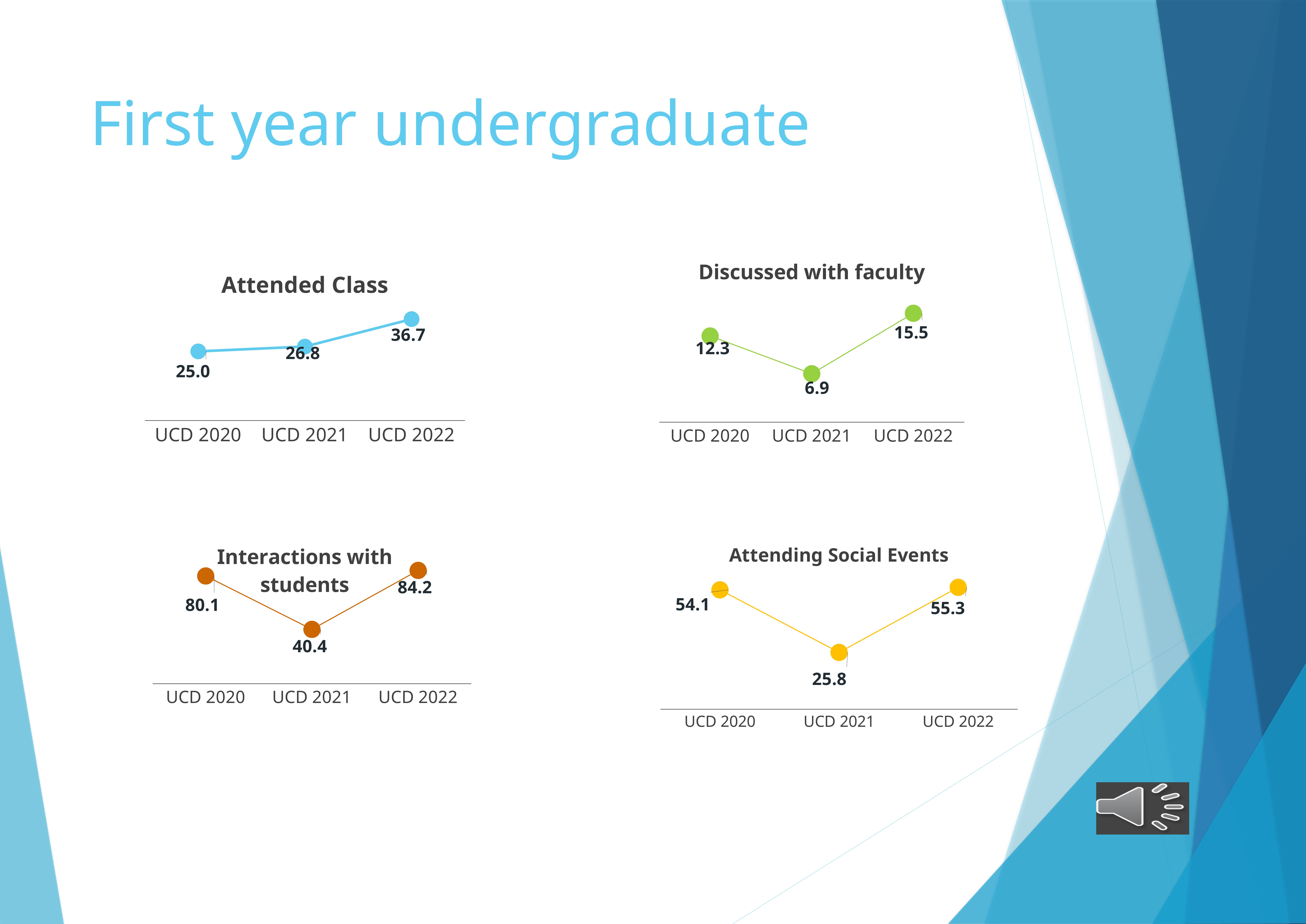
How many charts are shown on the slide? 4 In the 'Attended Class' chart, do the values rise or fall from UCD 2020 to UCD 2022? Rise In the 'Attended Class' chart, what is the difference between the UCD 2022 and UCD 2020 values? 11.7 In the 'Attending Social Events' chart, which category has the lowest value? UCD 2021 What kind of chart is the 'Attending Social Events' chart? Line chart In the 'Attended Class' chart, what is the value for UCD 2022? 36.7 In the 'Interactions with students' chart, which category has the highest value? UCD 2022 How many data points are plotted in the 'Attended Class' chart? 3 In the 'Attending Social Events' chart, what is the difference between the UCD 2020 and UCD 2021 values? 28.3 In the 'Interactions with students' chart, what is the value for UCD 2020? 80.1 In the 'Discussed with faculty' chart, which is larger, the value for UCD 2020 or UCD 2022? UCD 2022 In the 'Discussed with faculty' chart, what is the value for UCD 2021? 6.9